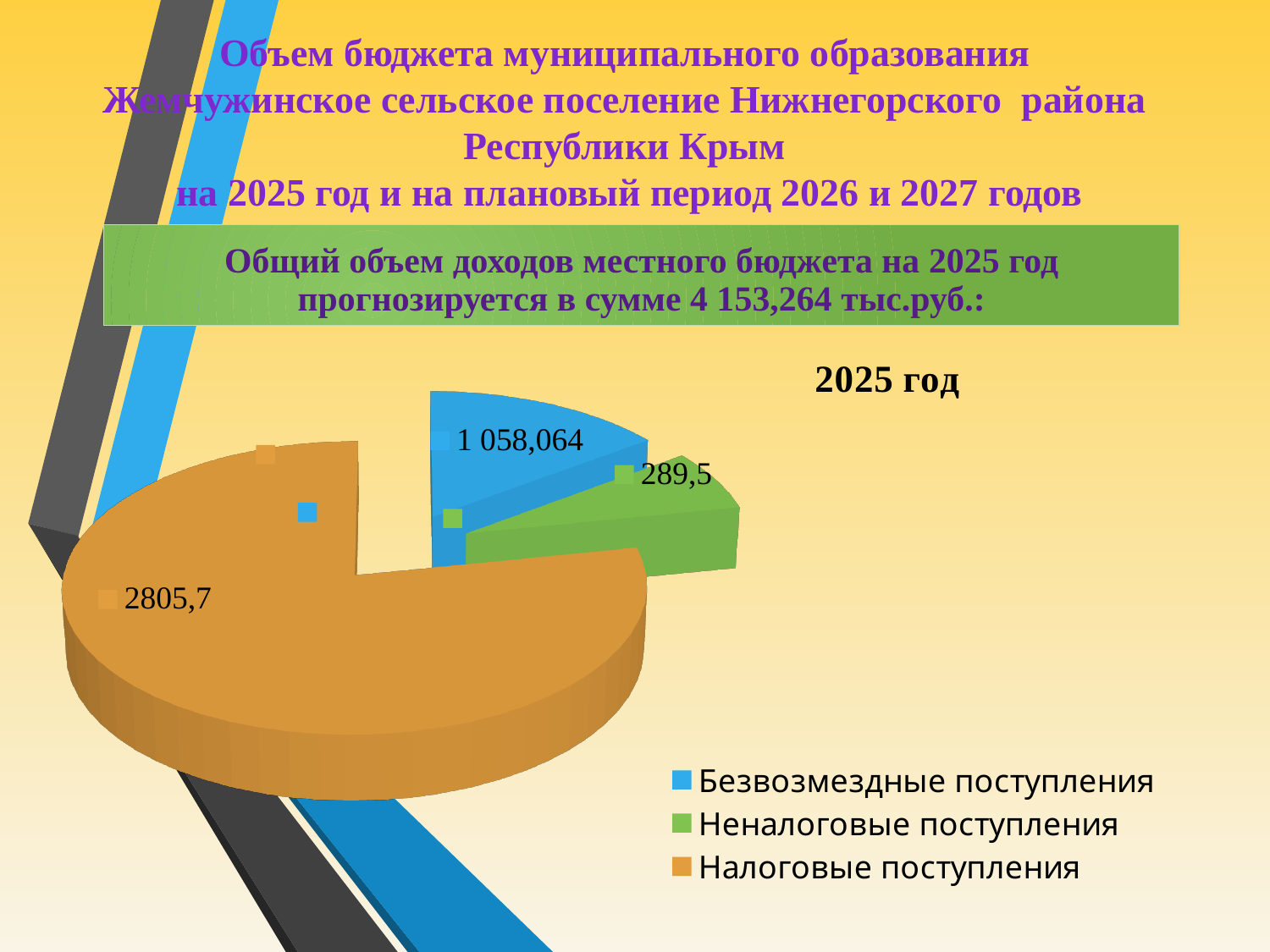
Which category has the smallest slice in the pie chart? Неналоговые поступления What is the value for Налоговые поступления in the pie chart? 2805,7 How many slices does the pie chart have? 3 What type of chart is shown on the slide? Pie chart What is the difference between Налоговые поступления and Неналоговые поступления? 2516,2 What is the difference between Безвозмездные поступления and Неналоговые поступления? 768,564 What is the value for Неналоговые поступления in the pie chart? 289,5 What is the value for Безвозмездные поступления in the pie chart? 1 058,064 Which category has the largest slice in the pie chart? Налоговые поступления Which is larger: Безвозмездные поступления or Неналоговые поступления? Безвозмездные поступления What colour is the slice for Неналоговые поступления? Green What is the title shown above the pie chart? 2025 год